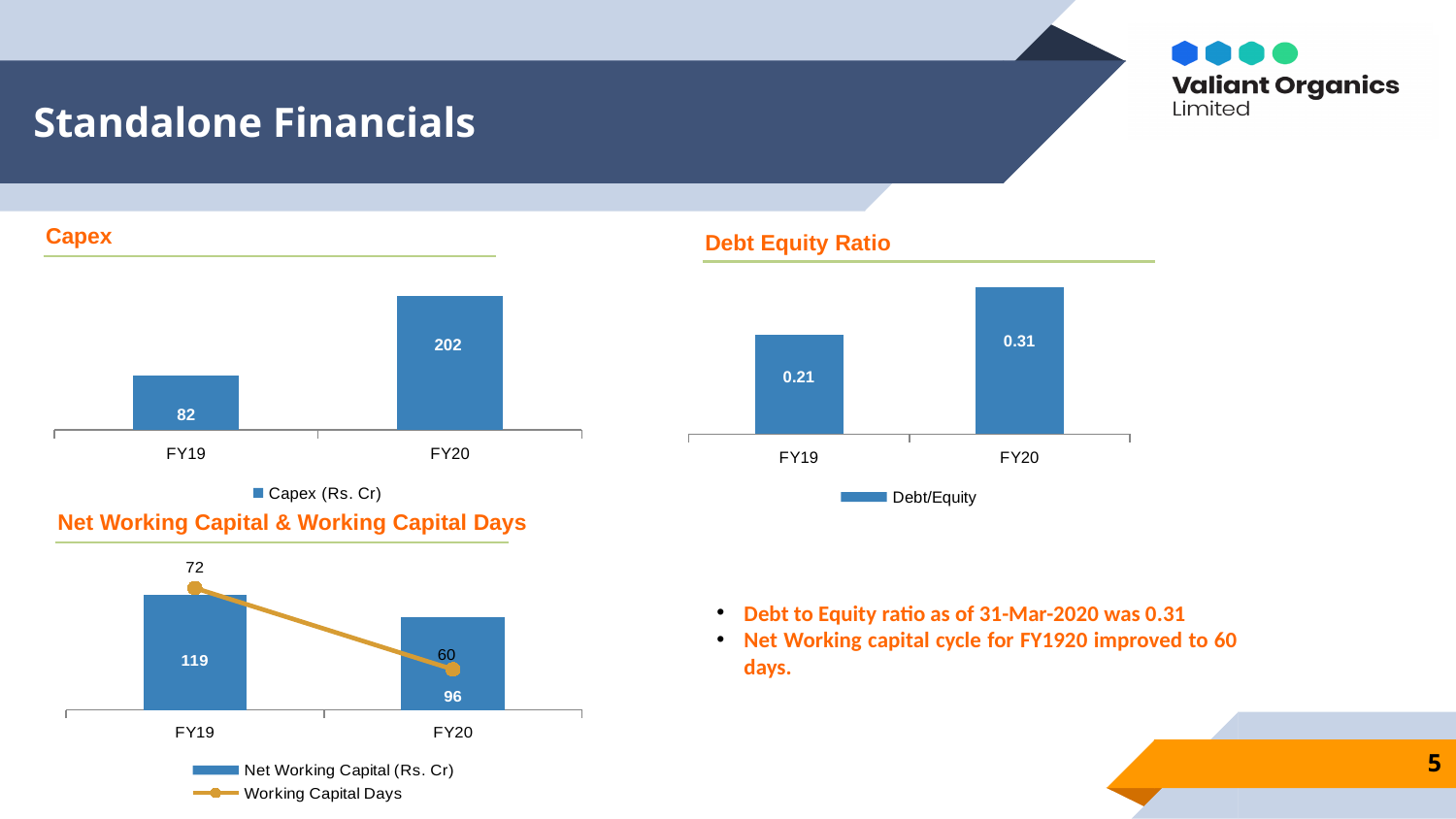
In the Capex chart, by how much did Capex increase from FY19 to FY20? 120 In the Capex chart, what is the Capex value for FY20? 202 In the Net Working Capital & Working Capital Days chart, do Working Capital Days rise or fall from FY19 to FY20? fall In the Debt Equity Ratio chart, what is the difference between the FY20 and FY19 Debt/Equity values? 0.10 In the Debt Equity Ratio chart, which year has the lower Debt/Equity ratio? FY19 In the Debt Equity Ratio chart, what is the Debt/Equity value for FY20? 0.31 In the Net Working Capital & Working Capital Days chart, by how much did Net Working Capital decrease from FY19 to FY20? 23 In the Net Working Capital & Working Capital Days chart, how many series does the legend list? 2 In the Net Working Capital & Working Capital Days chart, what is the Net Working Capital for FY19? 119 In the Capex chart, what is the Capex value for FY19? 82 What type of chart is the Capex chart? bar chart In the Net Working Capital & Working Capital Days chart, what is the Working Capital Days value for FY20? 60